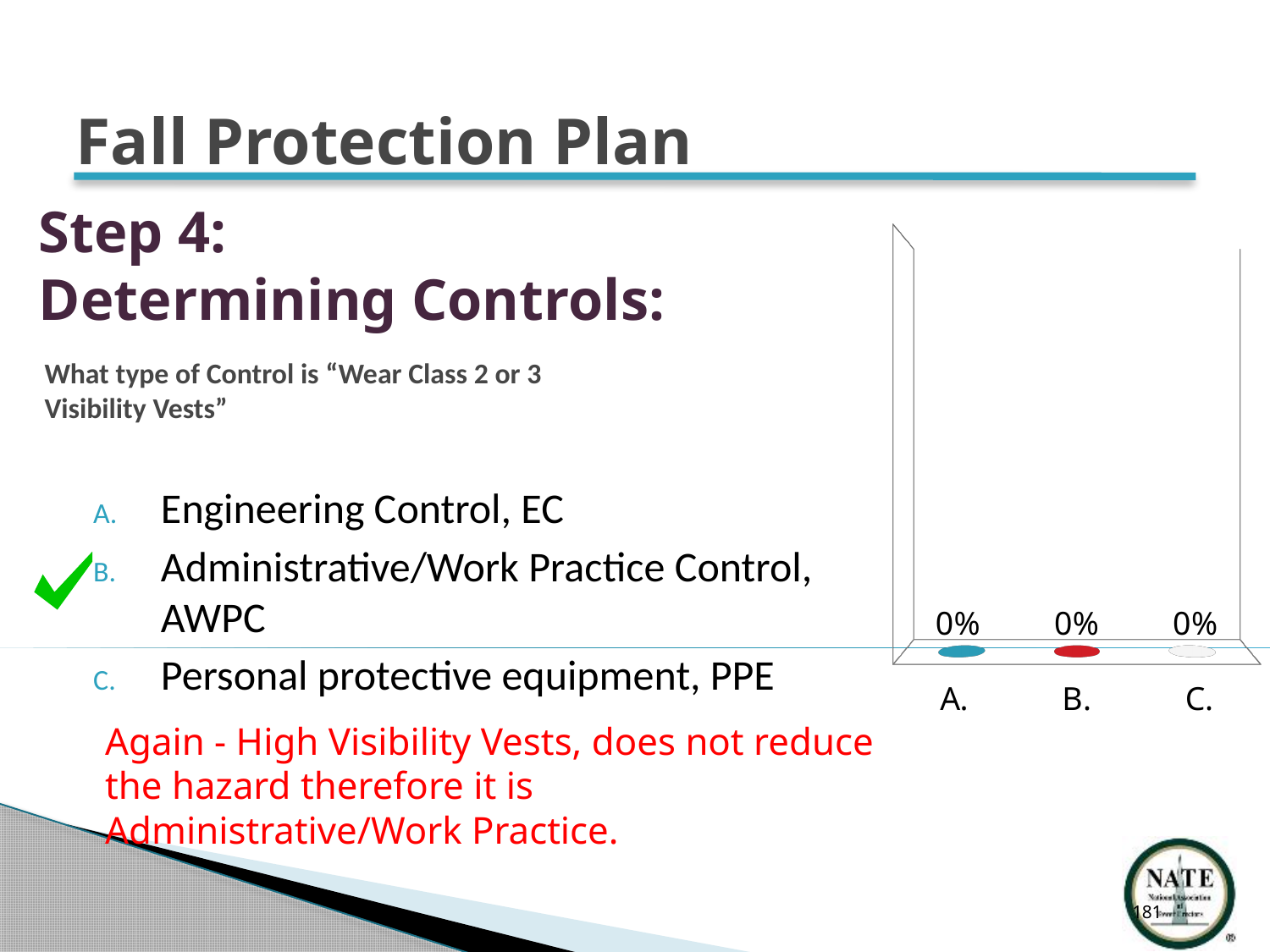
What colour is the marker for category A. in the chart? Blue What is the value shown for category A. in the chart? 0% What is the difference between the values for B. and C. in the chart? 0% What kind of chart is shown on the slide? Bar chart What is the value shown for category C. in the chart? 0% Do the values rise, fall, or stay the same from A. to C. in the chart? Stay the same What are the category labels along the x axis of the chart? A., B., C. What is the value shown for category B. in the chart? 0% What is the difference between the values for A. and B. in the chart? 0% How many categories are plotted in the chart? 3